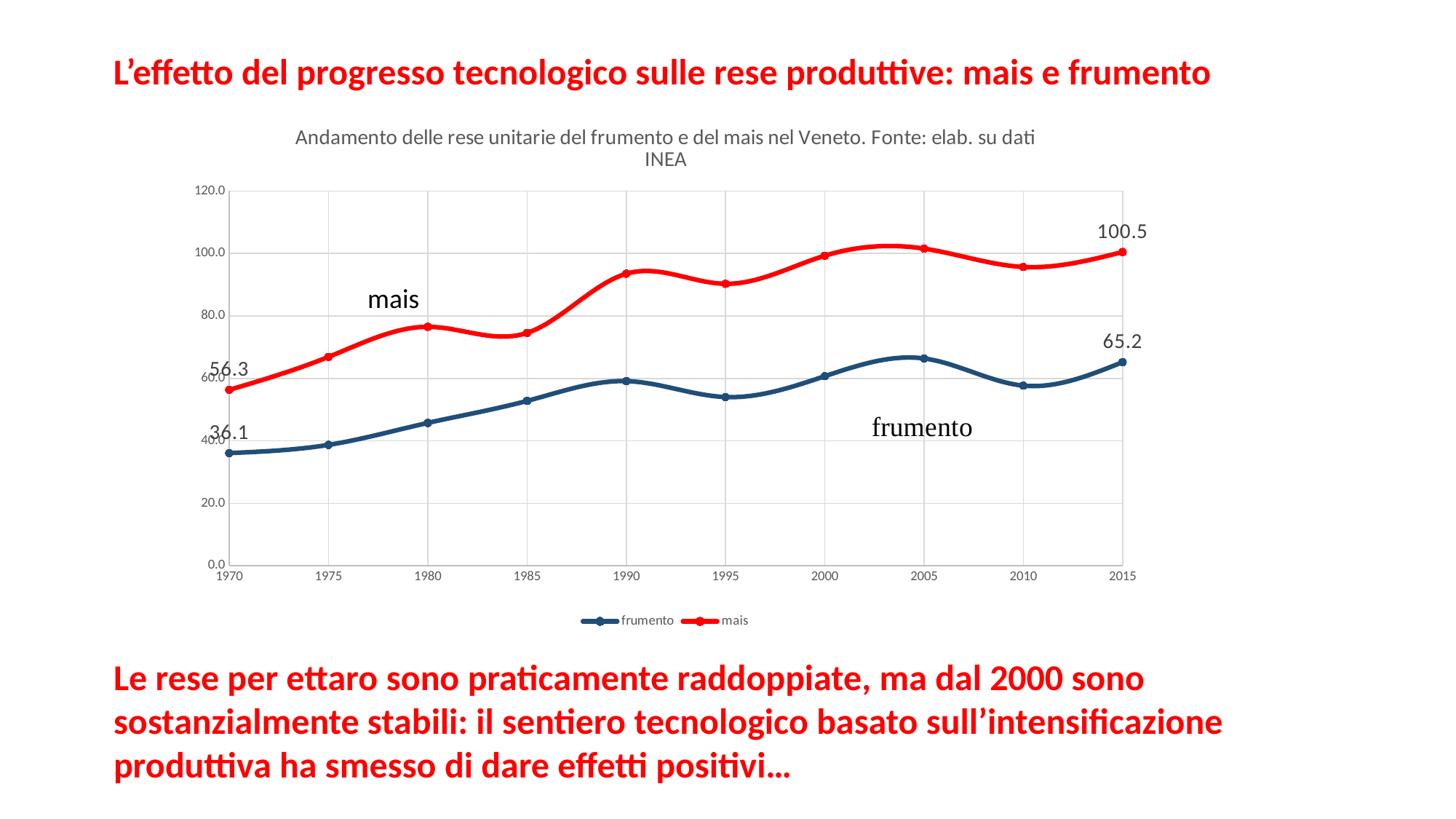
How many years are plotted on the x axis? 10 What is the value for mais in 1970? 56.3 Which series has the higher value in 2015, mais or frumento? mais What is the difference between the mais and frumento values in 2015? 35.3 What is the value for frumento in 1970? 36.1 What is the value for frumento in 2015? 65.2 What is the value for mais in 2015? 100.5 How many series does the legend list? 2 Is the value for mais in 1990 greater or less than 80? greater Is the value for frumento in 1995 greater or less than 60? less By how much did the mais value increase from 1970 to 2015? 44.2 In which year is the frumento series at its lowest? 1970